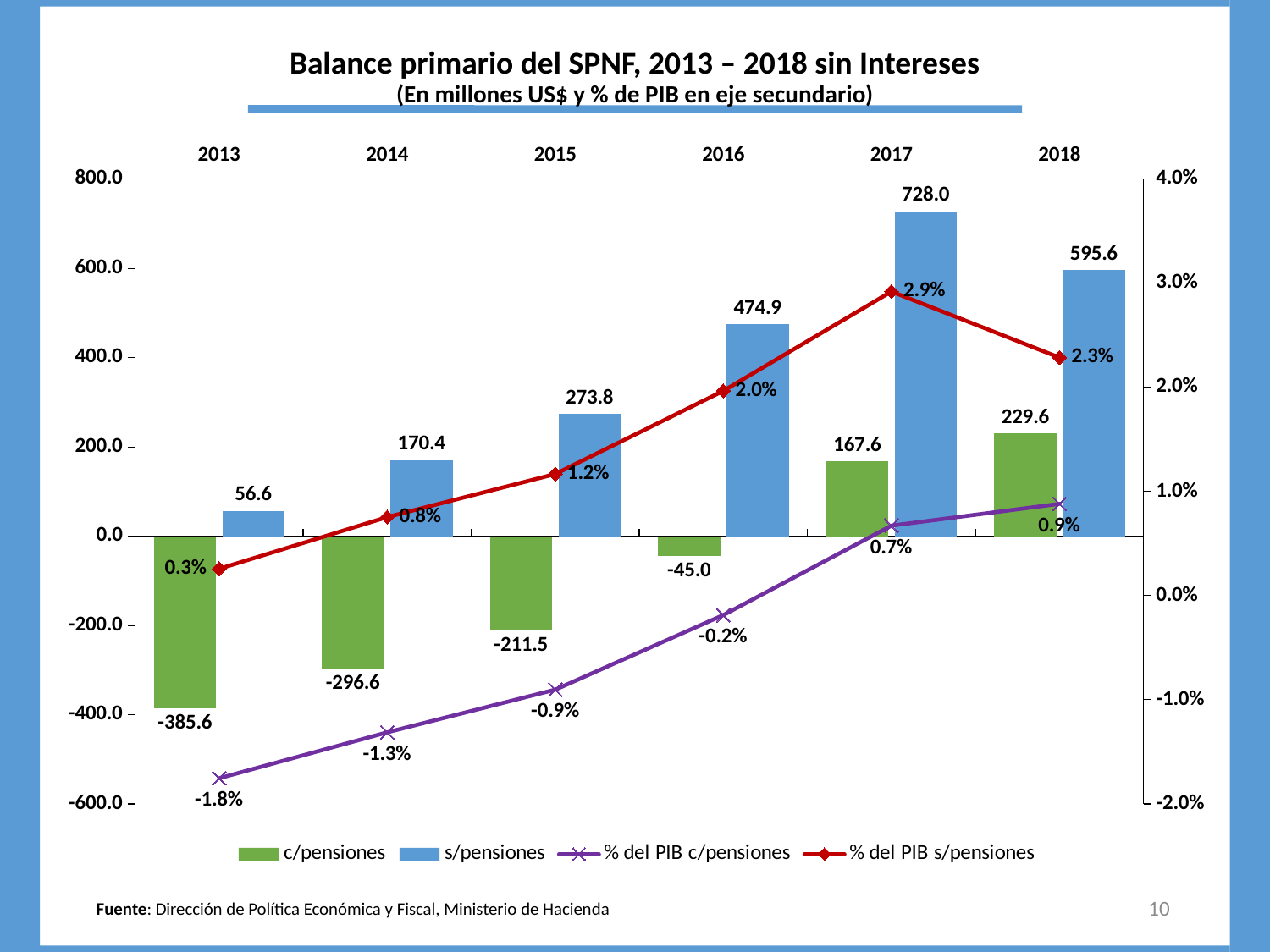
Which year has the highest s/pensiones value? 2017 What is the value of s/pensiones for 2017? 728.0 What is the % del PIB s/pensiones value for 2016? 2.0% Which year has the lowest c/pensiones value? 2013 How many series does the legend list? 4 How many years are shown on the x axis? 6 What is the value of c/pensiones for 2013? -385.6 What is the difference between the s/pensiones values for 2017 and 2018? 132.4 What is the title of the chart? Balance primario del SPNF, 2013 – 2018 sin Intereses Does the % del PIB c/pensiones line rise or fall from 2013 to 2018? rise Which is larger, the c/pensiones value for 2017 or for 2018? 2018 What is the % del PIB c/pensiones value for 2014? -1.3%